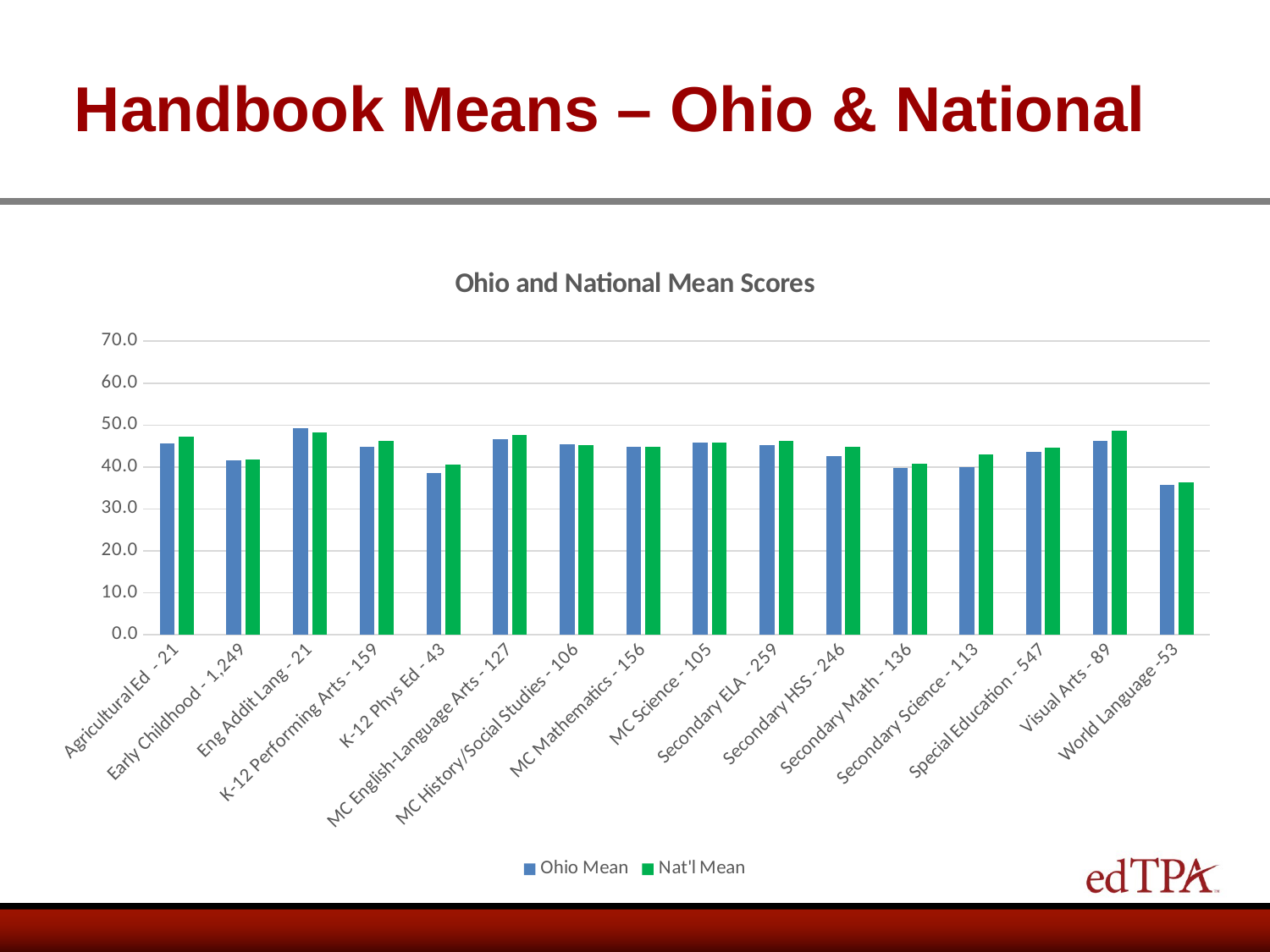
Which category has the lowest Ohio Mean? World Language -53 Is the Ohio Mean for World Language -53 greater or less than 40.0? less Which colour represents the Nat'l Mean series in the legend? Green What is the title of the chart? Ohio and National Mean Scores Which category has the highest Ohio Mean? Eng Addit Lang - 21 For Secondary Science - 113, which is larger: the Ohio Mean or the Nat'l Mean? Nat'l Mean What kind of chart is shown on the slide? Bar chart How many series does the legend list? 2 For Agricultural Ed - 21, which is larger: the Ohio Mean or the Nat'l Mean? Nat'l Mean Is the Nat'l Mean for Special Education - 547 greater or less than 40.0? greater How many categories are shown along the x axis? 16 Is the Ohio Mean for Eng Addit Lang - 21 greater or less than 40.0? greater